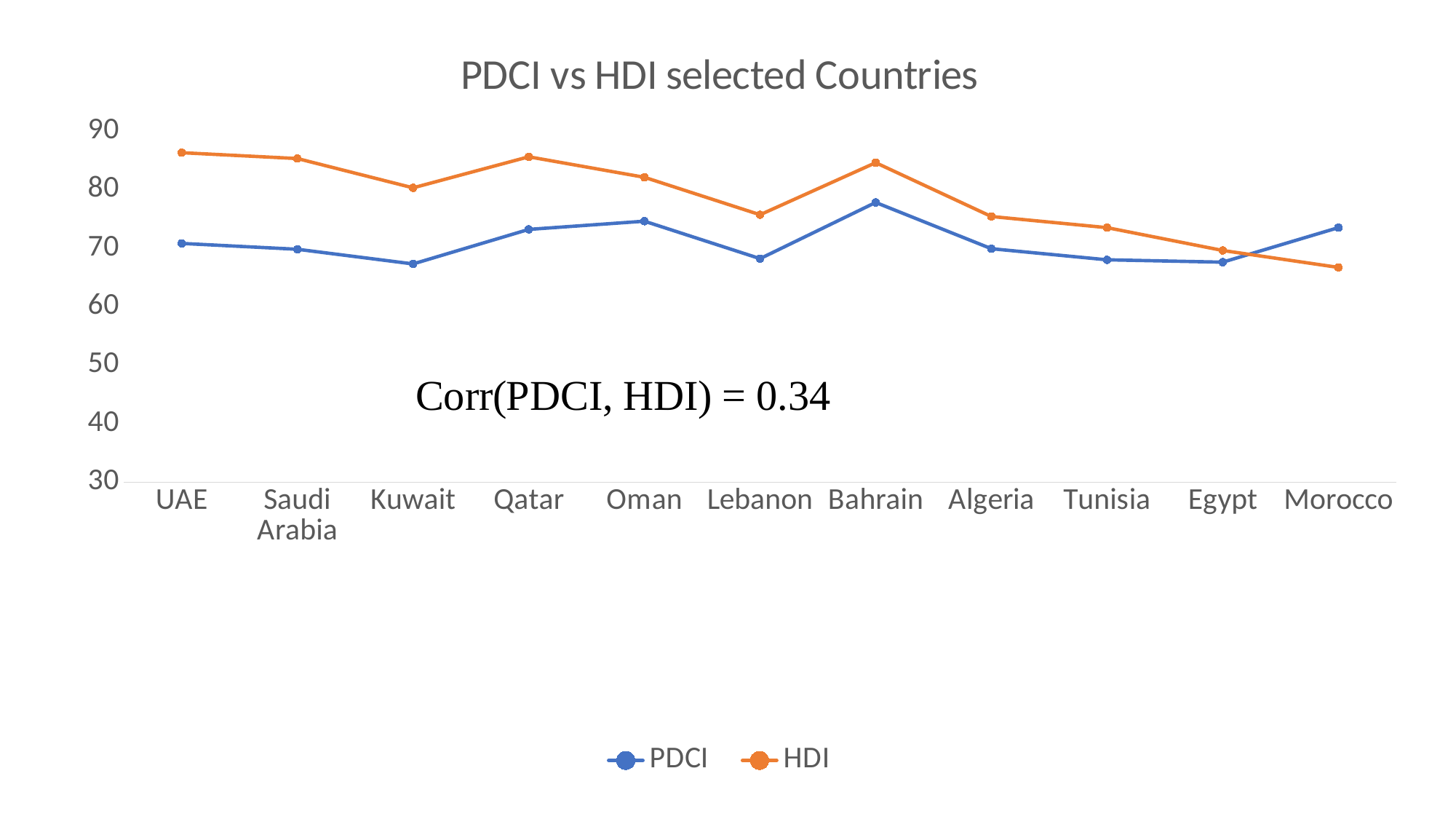
For UAE, which is larger, the PDCI value or the HDI value? HDI What kind of chart is shown on the slide? line chart Which country has the highest PDCI value? Bahrain How many countries are plotted along the x axis? 11 Does the HDI line generally rise or fall from UAE to Morocco? fall Is the PDCI value for Kuwait greater or less than 70? less How many series does the legend list? 2 Which country has the lowest HDI value? Morocco What correlation value between PDCI and HDI is printed on the chart? 0.34 Is the HDI value for UAE greater or less than 80? greater For Morocco, which is larger, the PDCI value or the HDI value? PDCI Is the HDI value for Morocco greater or less than 70? less